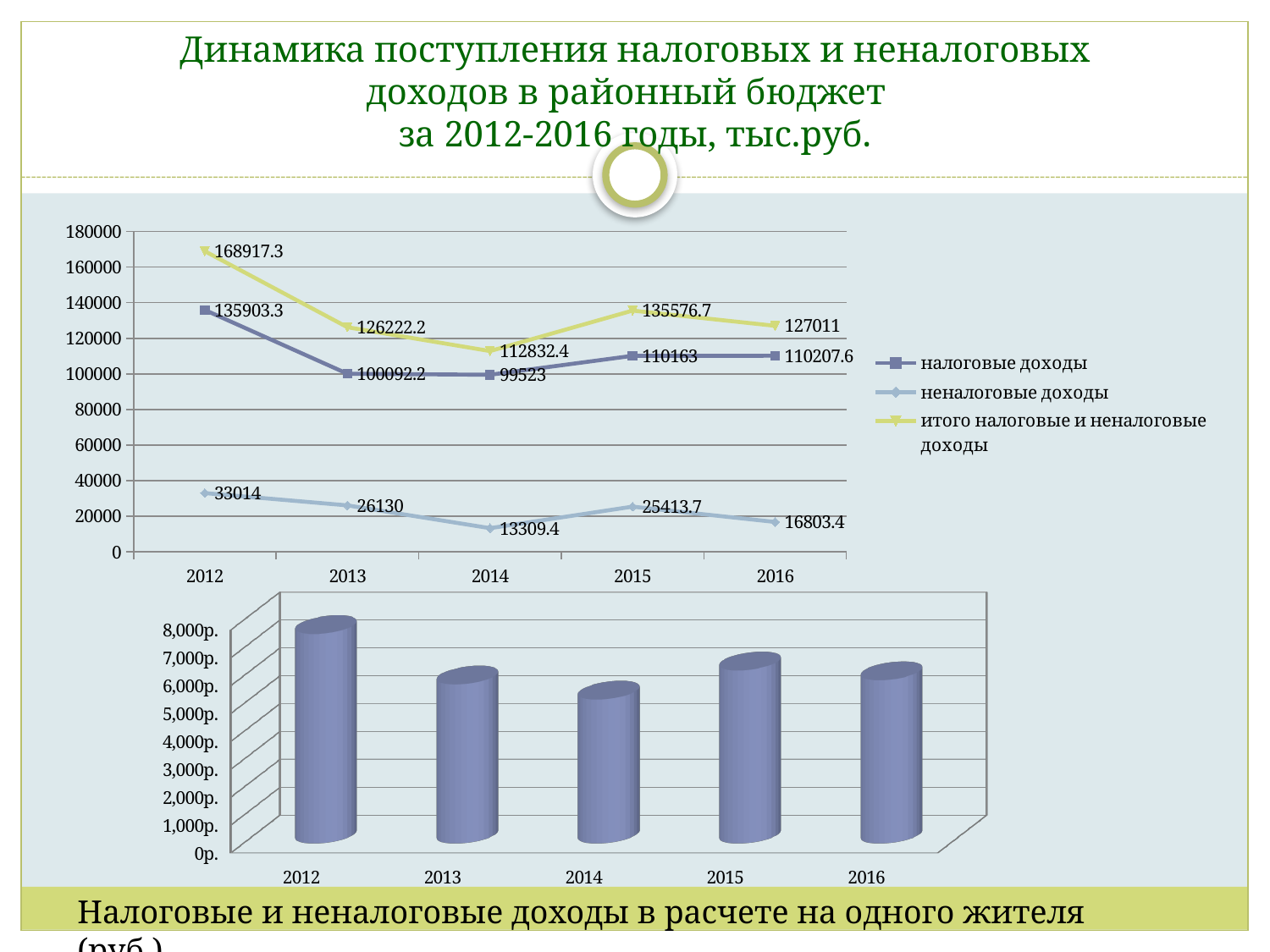
In the top line chart, what is the value of неналоговые доходы in 2014? 13309.4 In the bottom bar chart, which year has the lowest bar? 2014 In the top line chart, which is larger: неналоговые доходы in 2013 or in 2015? 2013 In the top line chart, in which year is неналоговые доходы lowest? 2014 In the top line chart, does неналоговые доходы rise or fall from 2012 to 2014? fall What kind of chart is the bottom chart on the slide? bar chart In the top line chart, what is the value of налоговые доходы in 2012? 135903.3 In the top line chart, in which year is итого налоговые и неналоговые доходы highest? 2012 In the top line chart, what is the value of итого налоговые и неналоговые доходы in 2016? 127011 In the top line chart, what is the difference between налоговые доходы in 2012 and in 2013? 35811.1 How many series does the legend of the top line chart list? 3 In the bottom bar chart, is the value for 2012 greater or less than 7,000р.? greater